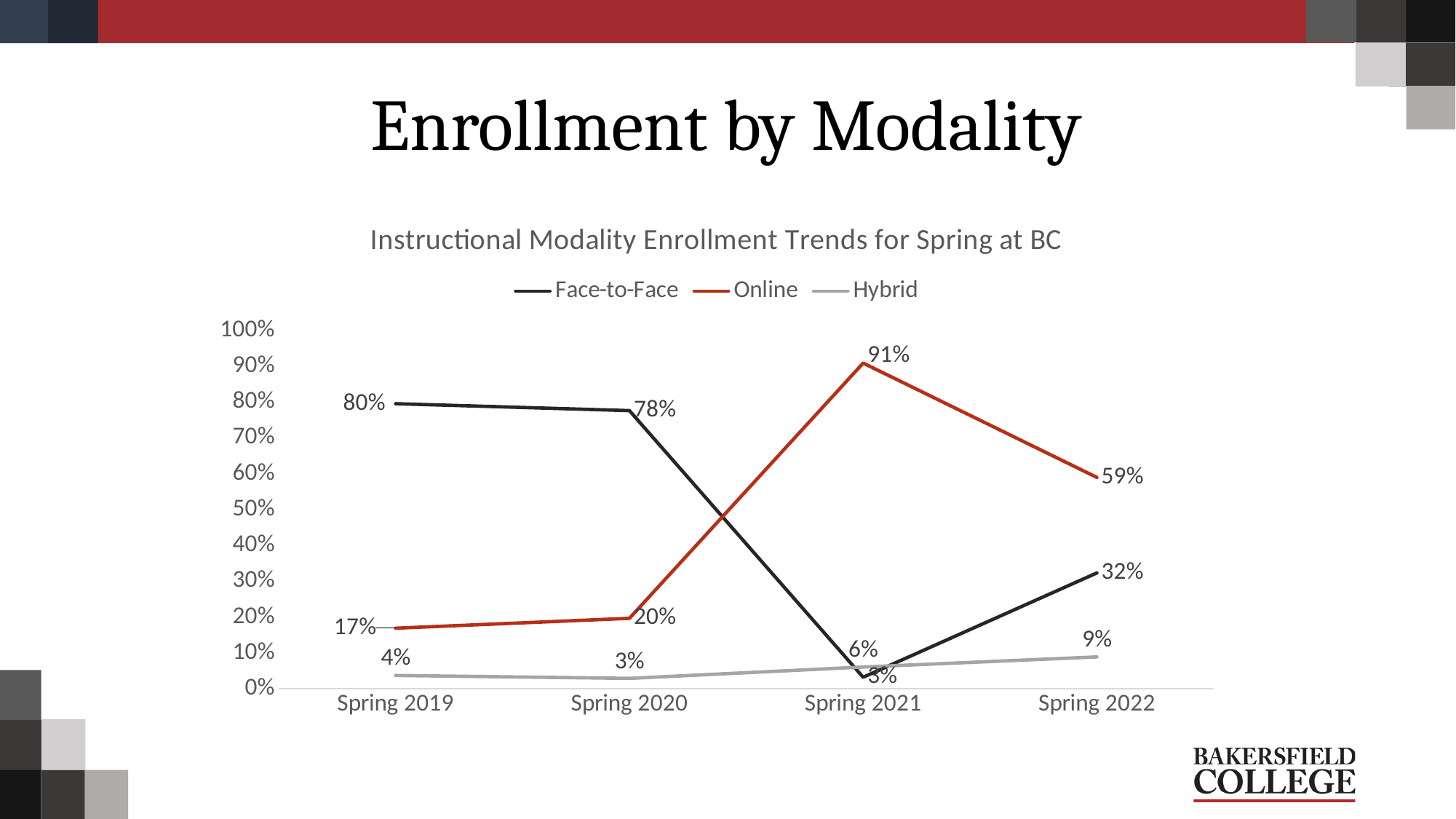
What is the difference between the Online share in Spring 2021 and Spring 2022? 32% How many series does the legend list? 3 In which spring term is the Face-to-Face share lowest? Spring 2021 What is the Face-to-Face enrollment share in Spring 2022? 32% In which spring term is the Online share highest? Spring 2021 What is the title of the chart? Instructional Modality Enrollment Trends for Spring at BC What is the Hybrid enrollment share in Spring 2022? 9% Which is larger in Spring 2020: the Face-to-Face share or the Online share? Face-to-Face What type of chart is shown on the slide? line chart What is the Online enrollment share in Spring 2021? 91% How many spring terms are plotted on the x axis? 4 What is the Face-to-Face enrollment share in Spring 2019? 80%